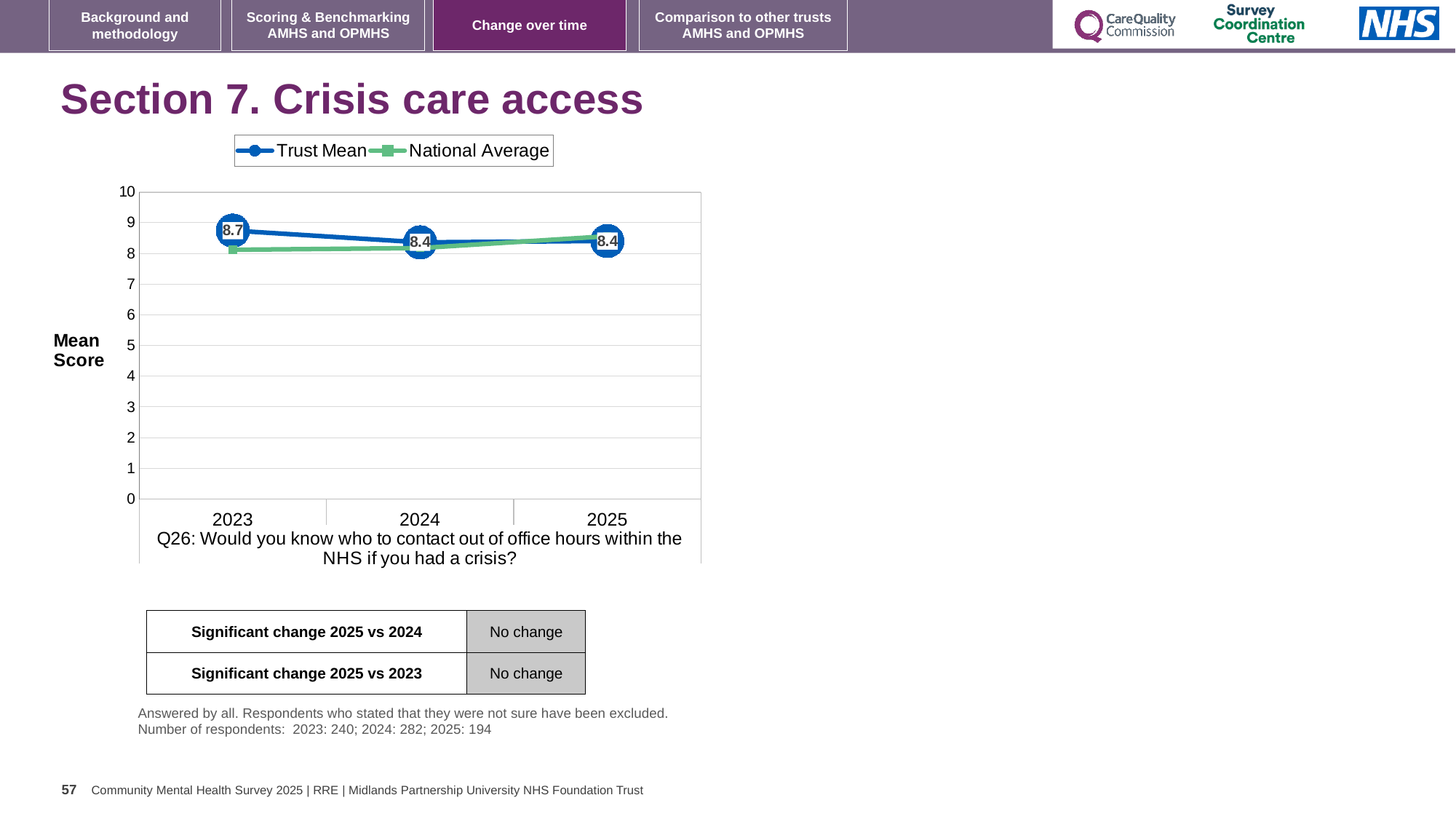
Which is larger, the Trust Mean in 2023 or the Trust Mean in 2025? 2023 How many series does the legend list? 2 What is the Trust Mean value for 2023? 8.7 In 2023, which series has the higher value, Trust Mean or National Average? Trust Mean In which year is the Trust Mean highest? 2023 How many years are shown on the x axis? 3 What kind of chart is shown on the slide? line chart What is the Trust Mean value for 2025? 8.4 Is the National Average value for 2023 greater or less than 5? greater What is the difference between the Trust Mean in 2023 and in 2024? 0.3 Does the Trust Mean rise or fall from 2023 to 2025? fall What is the Trust Mean value for 2024? 8.4